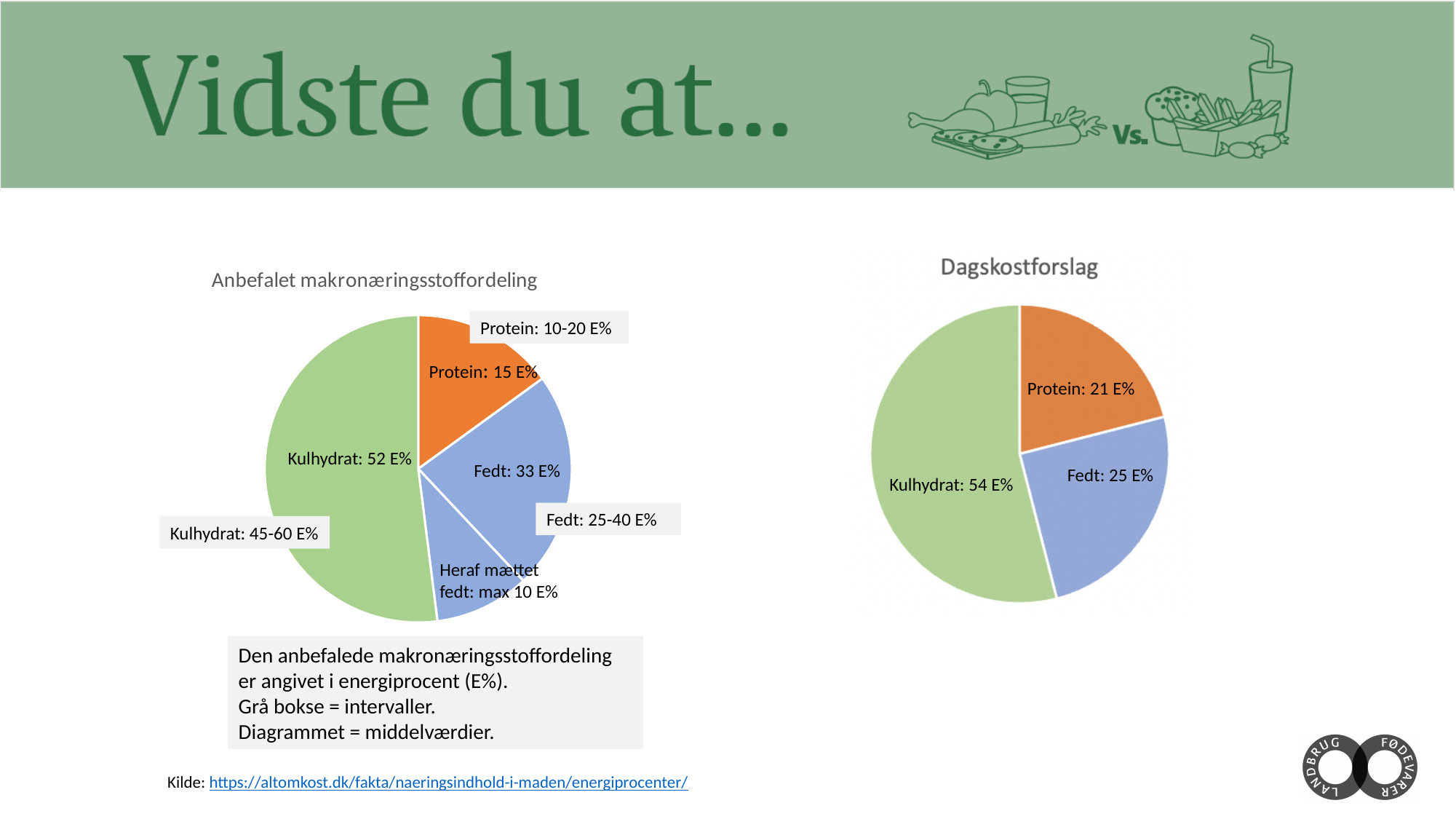
How many categories are shown in the 'Dagskostforslag' chart? 3 In the 'Anbefalet makronæringsstoffordeling' chart, which of the three main categories has the smallest slice? Protein In the 'Anbefalet makronæringsstoffordeling' chart, what interval is given in the grey box for Kulhydrat? 45-60 E% In the 'Dagskostforslag' chart, what is the difference between Kulhydrat and Fedt? 29 E% In the 'Dagskostforslag' chart, which category has the largest slice? Kulhydrat What type of chart is the 'Dagskostforslag' chart? Pie chart In the 'Anbefalet makronæringsstoffordeling' chart, what is the value for Fedt? 33 E% Which is larger: Fedt in the 'Anbefalet makronæringsstoffordeling' chart or Fedt in the 'Dagskostforslag' chart? Fedt in the 'Anbefalet makronæringsstoffordeling' chart In the 'Anbefalet makronæringsstoffordeling' chart, what is the value for Protein? 15 E% In the 'Dagskostforslag' chart, what is the value for Fedt? 25 E% In the 'Dagskostforslag' chart, what is the value for Protein? 21 E% In the 'Anbefalet makronæringsstoffordeling' chart, what is the value for Kulhydrat? 52 E%